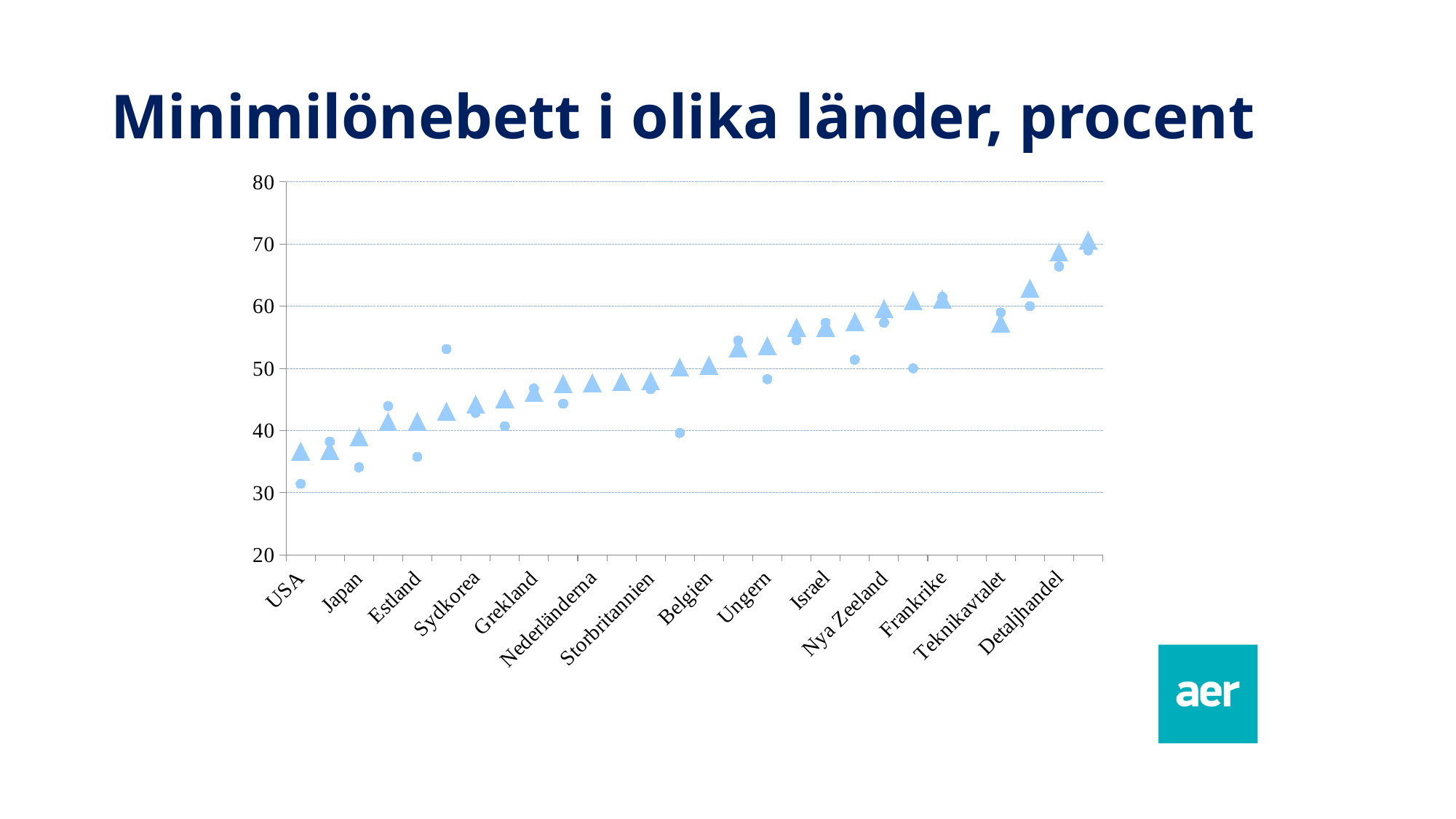
Is the triangle marker value for Detaljhandel greater or less than 60? greater What kind of chart is shown on the slide? scatter chart Is the triangle marker value for Teknikavtalet greater or less than 60? less Is the circle marker value for Ungern greater or less than 50? less What is the title of the chart? Minimilönebett i olika länder, procent Do the triangle markers generally rise or fall from left to right along the x axis? rise